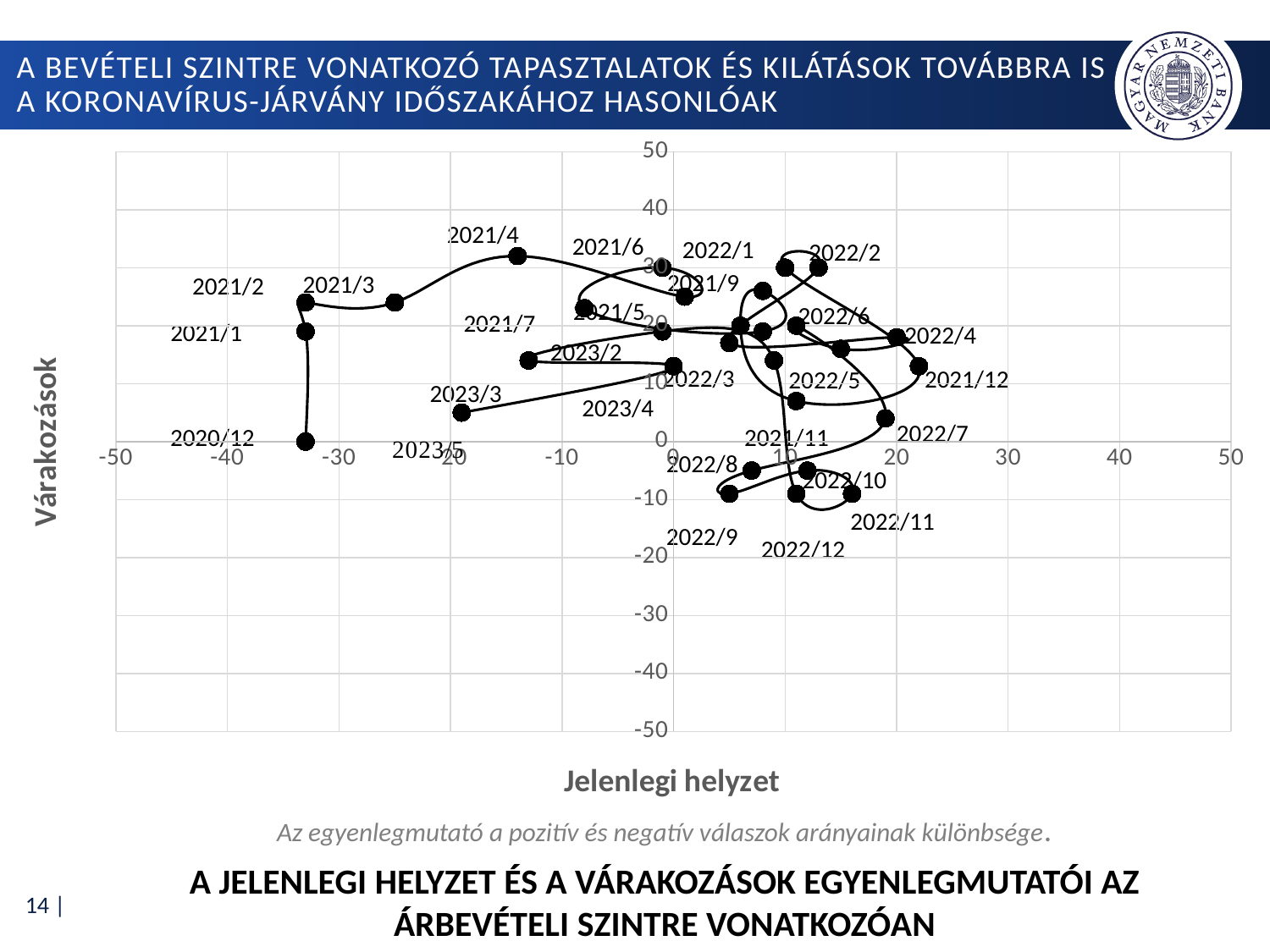
What is the label of the vertical axis of the chart? Várakozások Is the Jelenlegi helyzet value for 2022/4 greater or less than 10? greater Which point has the higher Jelenlegi helyzet value, 2022/2 or 2021/2? 2022/2 Is the Várakozások value for 2020/12 greater or less than 10? less Which point has the higher Várakozások value, 2021/4 or 2020/12? 2021/4 Is the Várakozások value for 2021/4 greater or less than 20? greater What is the label of the horizontal axis of the chart? Jelenlegi helyzet Which point has the higher Várakozások value, 2022/1 or 2022/11? 2022/1 What kind of chart is shown on the slide? Scatter chart